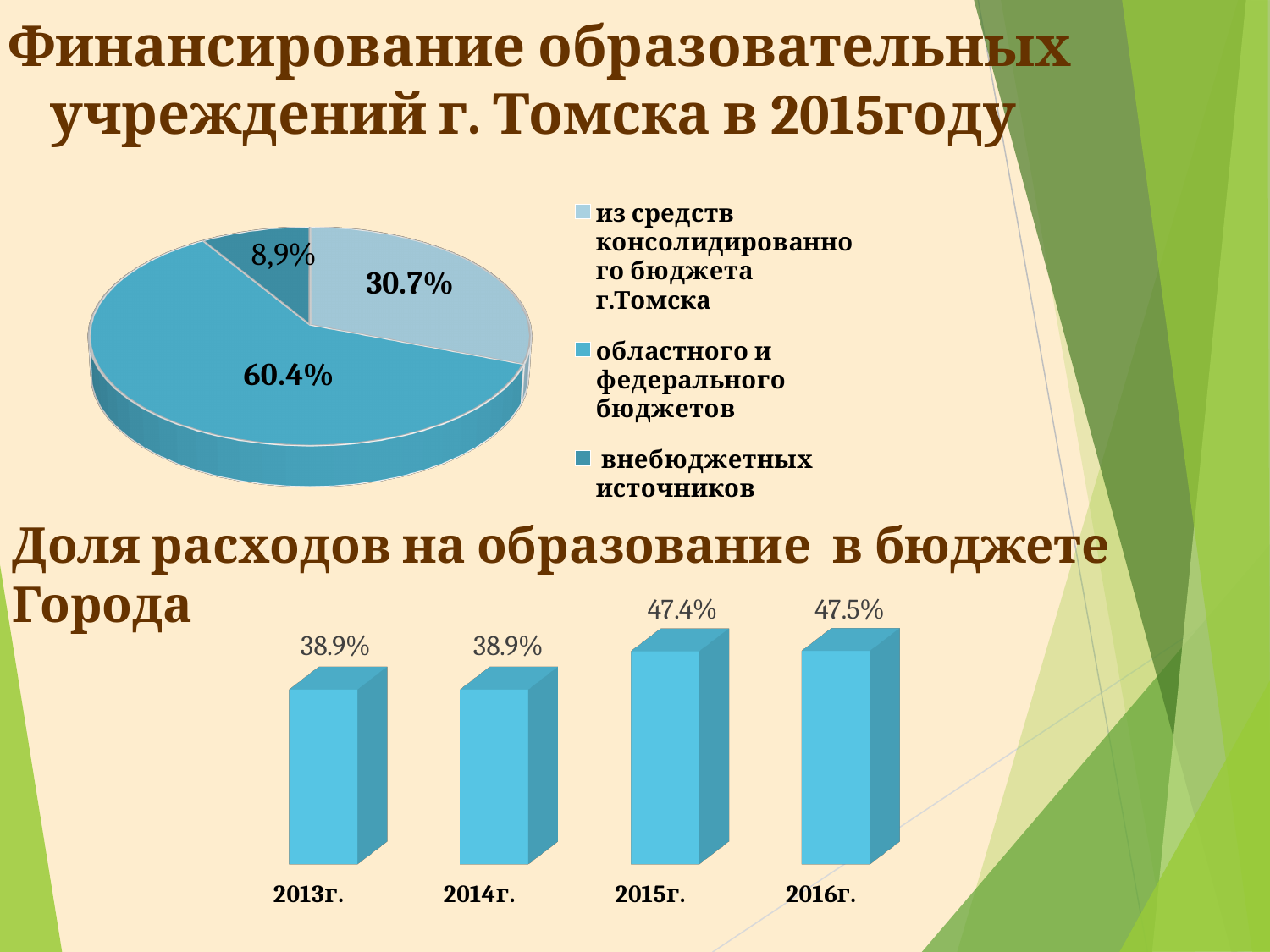
What kind of chart is the top chart on the slide? pie chart In the pie chart at the top of the slide, what share comes from областного и федерального бюджетов? 60.4% In the bar chart 'Доля расходов на образование в бюджете Города', which year has the highest value? 2016г. In the bar chart 'Доля расходов на образование в бюджете Города', what is the difference between the values for 2015г. and 2014г.? 8.5% In the pie chart at the top of the slide, which source has the largest share? областного и федерального бюджетов In the pie chart at the top of the slide, which source has the smallest share? внебюджетных источников In the bar chart 'Доля расходов на образование в бюджете Города', how many years are shown? 4 In the bar chart 'Доля расходов на образование в бюджете Города', what is the value for 2013г.? 38.9% In the pie chart at the top of the slide, how many entries does the legend list? 3 In the pie chart at the top of the slide, what share comes from средств консолидированного бюджета г.Томска? 30.7% In the bar chart 'Доля расходов на образование в бюджете Города', what is the value for 2015г.? 47.4% In the pie chart at the top of the slide, what share comes from внебюджетных источников? 8,9%